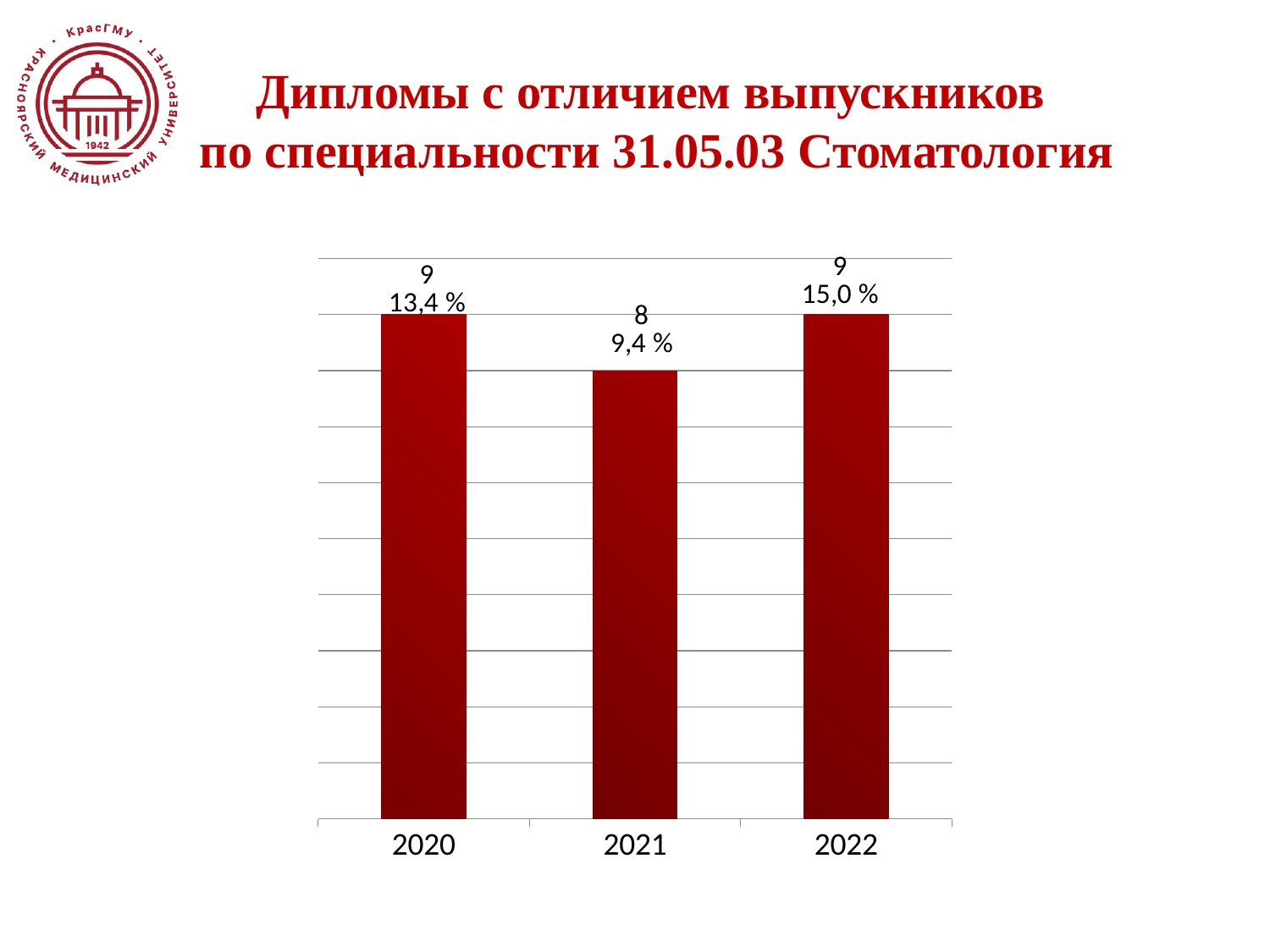
Which year has the lowest bar? 2021 What is the difference between the number of diplomas in 2020 and in 2021? 1 Which specialty code is named in the slide title? 31.05.03 How many diplomas with distinction are shown for 2021? 8 How many diplomas with distinction are shown for 2020? 9 What kind of chart is shown on the slide? Bar chart What percentage is shown above the bar for 2021? 9,4 % What percentage is shown above the bar for 2022? 15,0 % Does the number of diplomas rise or fall from 2020 to 2021? Fall What percentage is shown above the bar for 2020? 13,4 % How many years are shown on the x axis? 3 Which is larger, the percentage for 2022 or the percentage for 2020? 2022